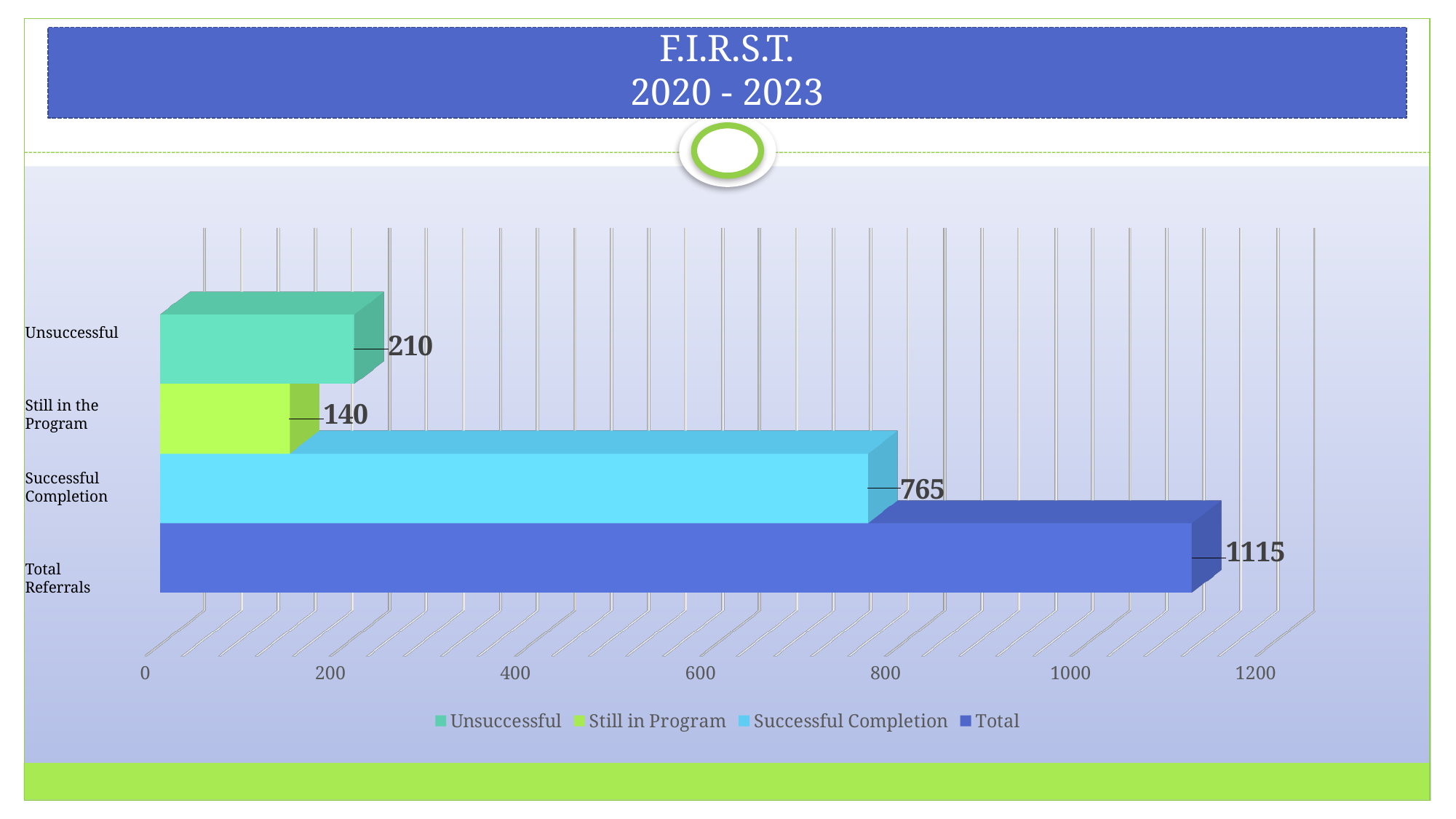
Which is larger, Unsuccessful or Still in the Program? Unsuccessful What is the value for Total Referrals? 1115 What is the value for Successful Completion? 765 Which category has the highest value? Total Referrals What is the difference between Unsuccessful and Still in the Program? 70 What is the difference between Total Referrals and Successful Completion? 350 Which category has the lowest value? Still in the Program What is the value for Still in the Program? 140 What kind of chart is shown on the slide? Bar chart What is the value for Unsuccessful? 210 How many categories are shown in the chart? 4 How many entries does the legend list? 4